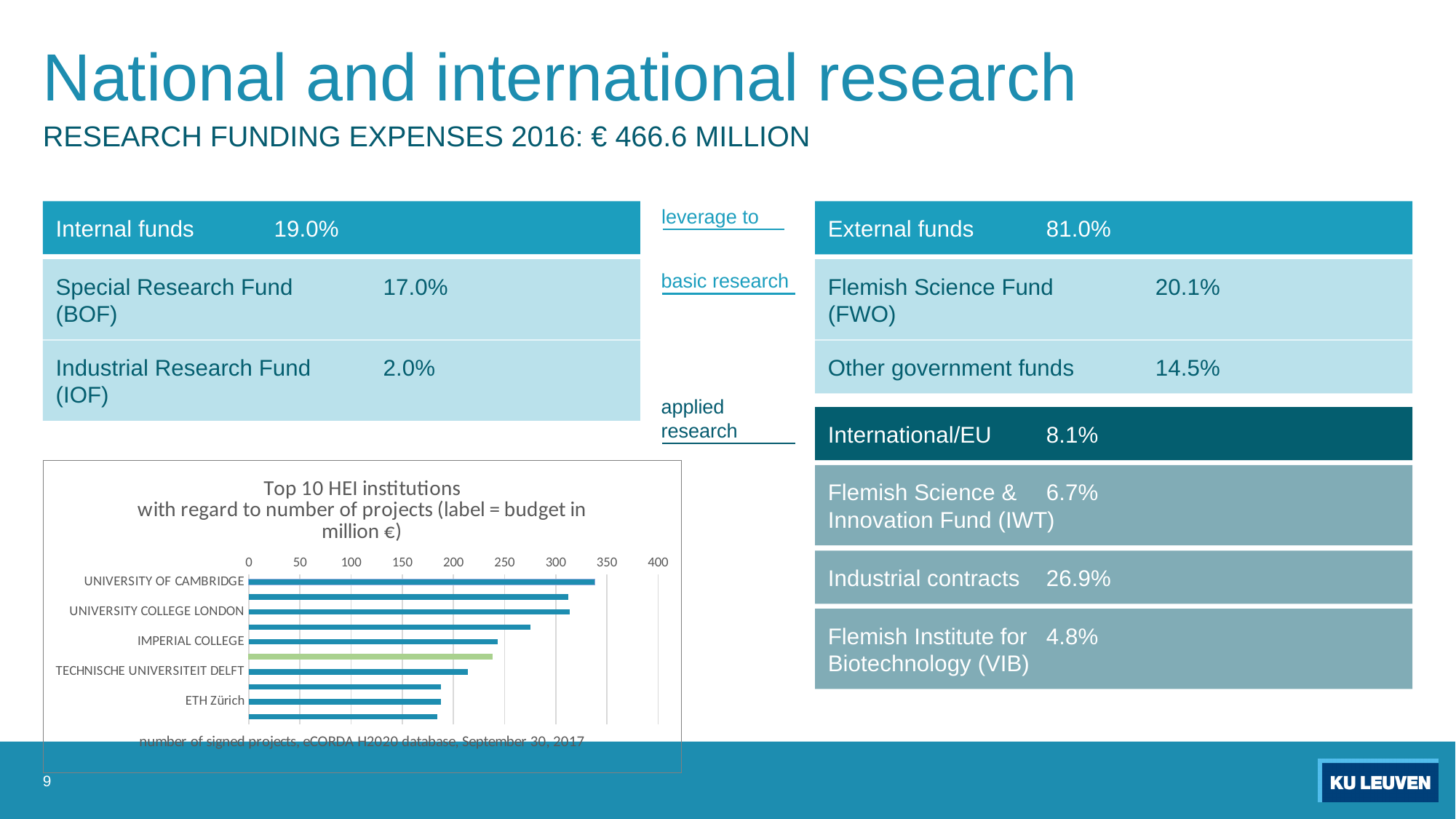
Is the value for TECHNISCHE UNIVERSITEIT DELFT greater or less than 250? less Is the value for IMPERIAL COLLEGE greater or less than 200? greater Which institution has the highest number of projects in the chart? UNIVERSITY OF CAMBRIDGE Is the value for UNIVERSITY OF CAMBRIDGE greater or less than 300? greater What is the highest tick value shown on the chart's horizontal axis? 400 Do the bar values increase or decrease from the top of the chart to the bottom? decrease Which has more projects, UNIVERSITY OF CAMBRIDGE or ETH Zürich? UNIVERSITY OF CAMBRIDGE How many bars does the 'Top 10 HEI institutions' chart show? 10 What kind of chart is shown on the slide? bar chart Which has more projects, IMPERIAL COLLEGE or ETH Zürich? IMPERIAL COLLEGE